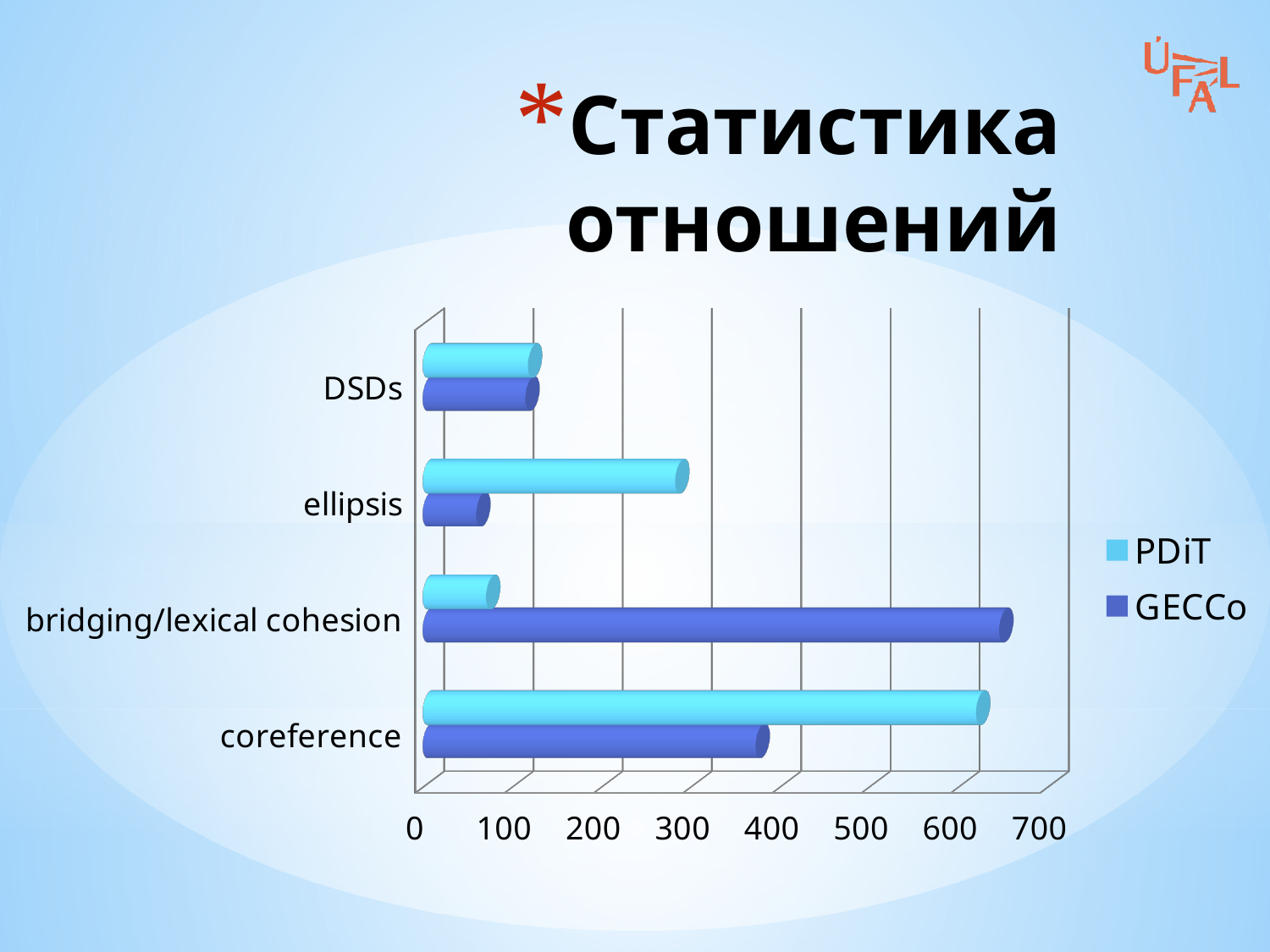
How many categories are shown on the vertical axis of the chart? 4 Which category has the lowest GECCo value? ellipsis Which category has the highest GECCo value? bridging/lexical cohesion Which category has the highest PDiT value? coreference Is the PDiT value for ellipsis greater or less than 200? greater For bridging/lexical cohesion, which series has the larger value, PDiT or GECCo? GECCo What kind of chart is shown on the slide? bar chart Which series are listed in the chart legend? PDiT and GECCo For ellipsis, which series has the larger value, PDiT or GECCo? PDiT How many series does the legend list? 2 Is the GECCo value for coreference greater or less than 400? less Which category has the lowest PDiT value? bridging/lexical cohesion